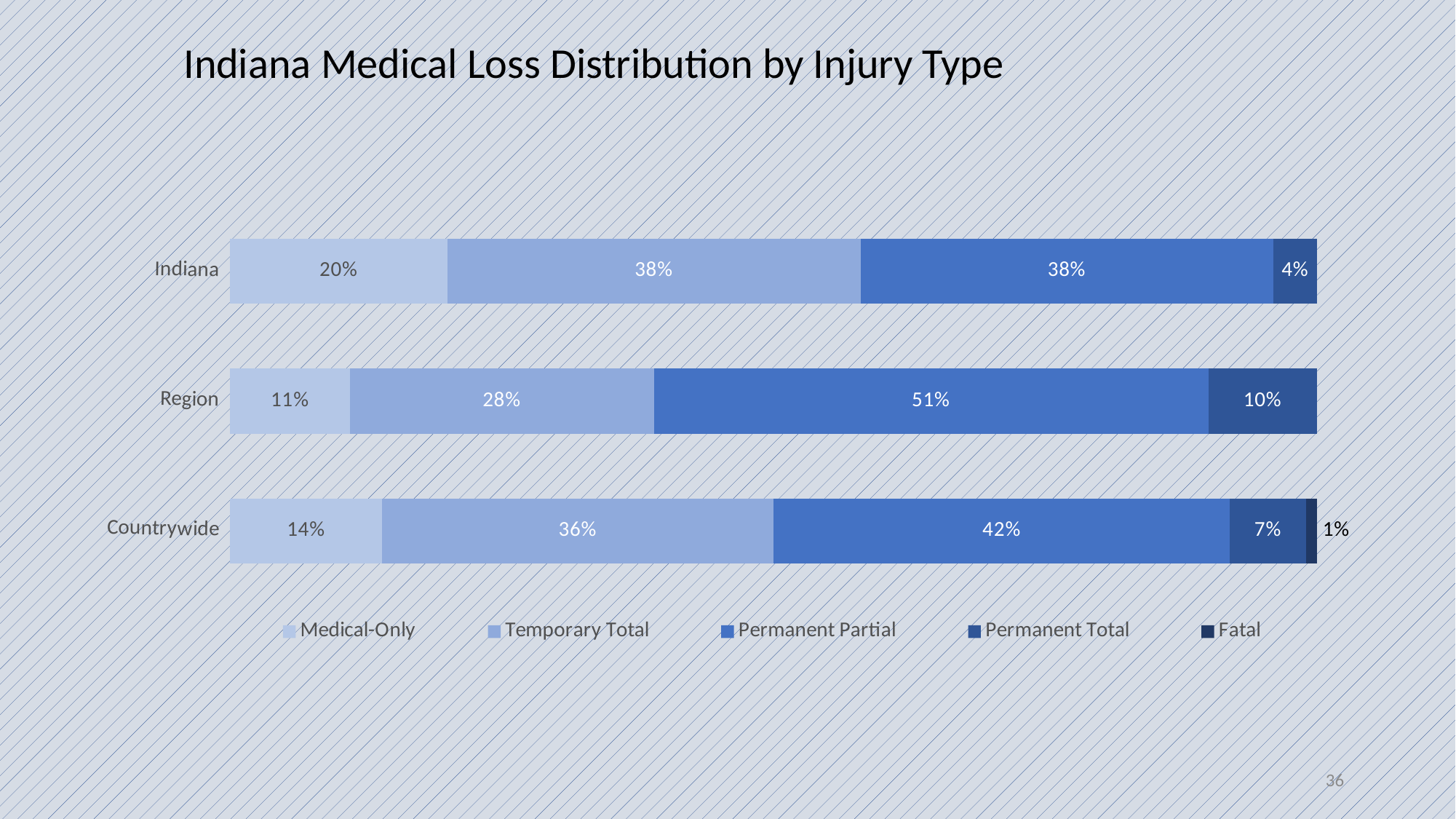
What is the Medical-Only share for Indiana? 20% What is the difference between the Temporary Total shares for Indiana and Region? 10% What is the Permanent Total share for Indiana? 4% How many categories are shown on the chart? 3 Which category has the lowest Medical-Only share? Region What is the Fatal share for Countrywide? 1% What is the title of the chart? Indiana Medical Loss Distribution by Injury Type What is the Permanent Partial share for Region? 51% Which is larger, the Permanent Total share for Region or for Countrywide? Region Which category has the highest Permanent Partial share? Region What type of chart is shown on the slide? Stacked bar chart How many series does the legend list? 5